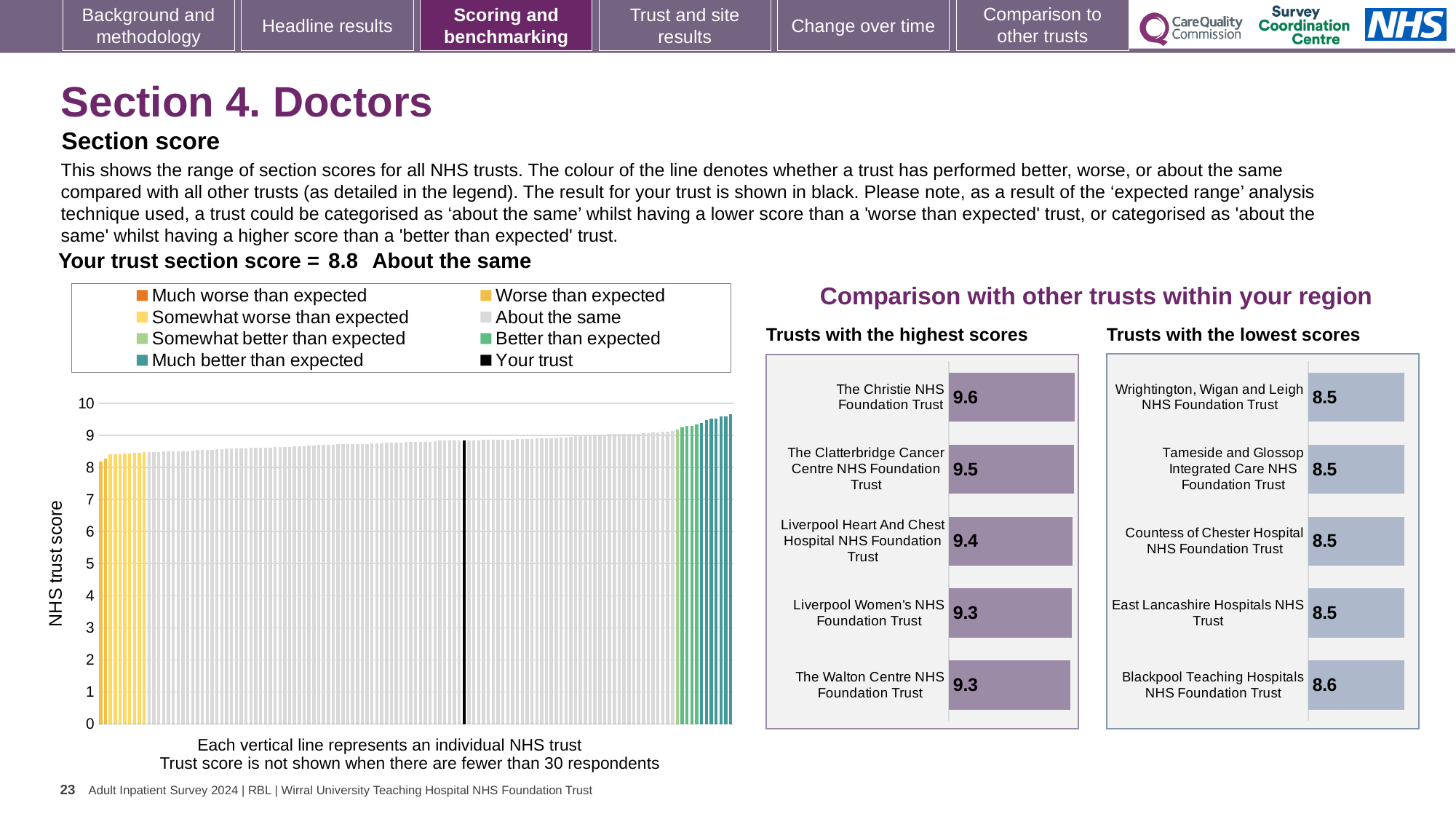
In the large chart on the left showing all NHS trusts, what is the section score for your trust (the black line)? 8.8 In the 'Trusts with the lowest scores' chart, what is the score for Blackpool Teaching Hospitals NHS Foundation Trust? 8.6 Which is larger: the score for The Clatterbridge Cancer Centre NHS Foundation Trust in the highest scores chart, or the score for Blackpool Teaching Hospitals NHS Foundation Trust in the lowest scores chart? The Clatterbridge Cancer Centre NHS Foundation Trust In the 'Trusts with the highest scores' chart, what is the score for Liverpool Heart And Chest Hospital NHS Foundation Trust? 9.4 In the 'Trusts with the highest scores' chart, how many trusts are shown? 5 In the 'Trusts with the highest scores' chart, what is the difference between the scores of The Christie NHS Foundation Trust and The Walton Centre NHS Foundation Trust? 0.3 In the 'Trusts with the highest scores' chart, what is the score for The Christie NHS Foundation Trust? 9.6 How many entries does the legend of the large chart on the left list? 8 In the 'Trusts with the lowest scores' chart, which trust has the highest score? Blackpool Teaching Hospitals NHS Foundation Trust In the 'Trusts with the lowest scores' chart, what is the score for Countess of Chester Hospital NHS Foundation Trust? 8.5 In the 'Trusts with the highest scores' chart, which trust has the highest score? The Christie NHS Foundation Trust What kind of chart is the large chart on the left showing NHS trust scores? Bar chart